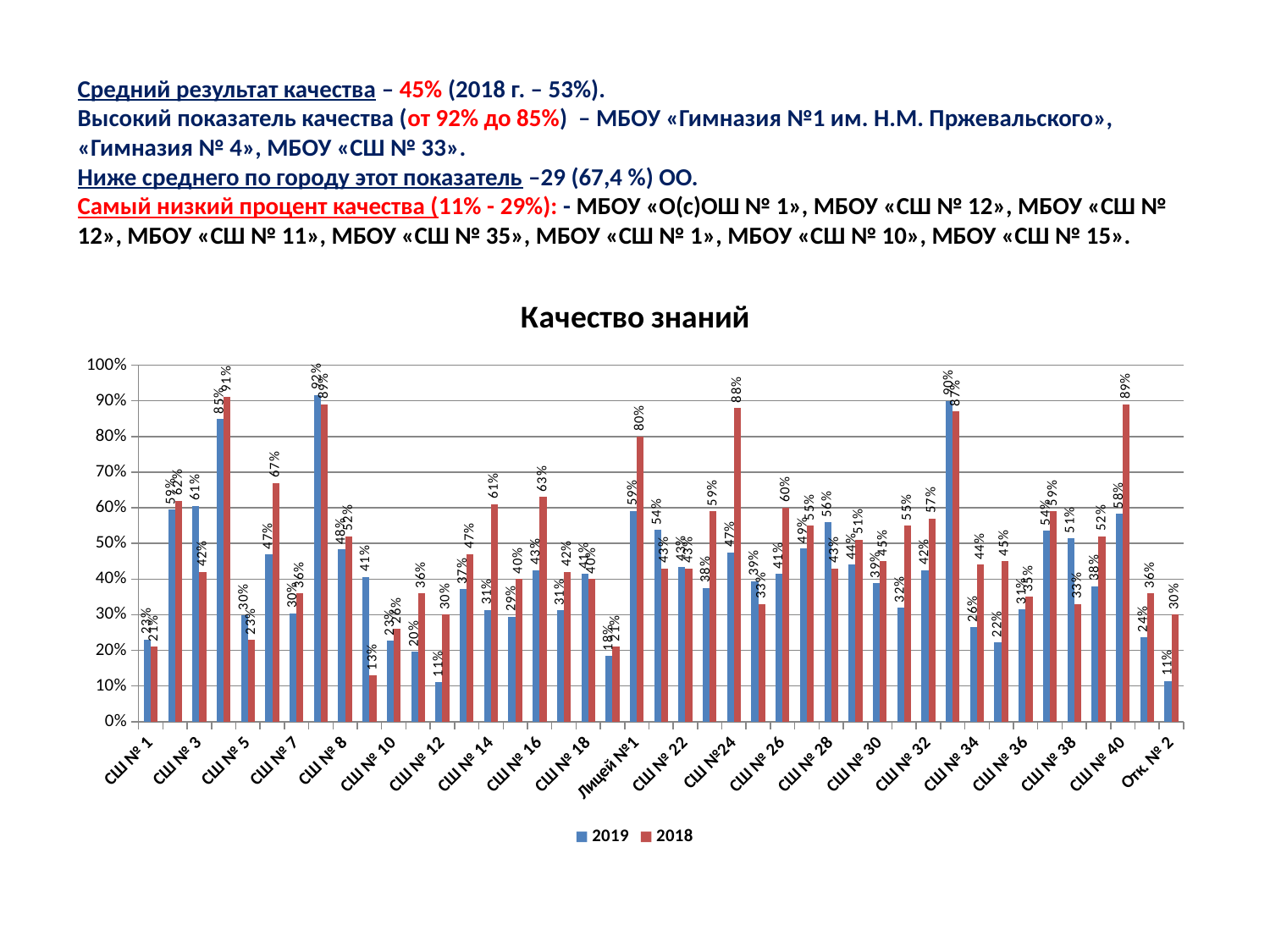
What is the title of the chart? Качество знаний For СШ № 14, which year has the larger value, 2019 or 2018? 2018 What is the difference between the 2019 and 2018 values for СШ № 3? 19 percentage points What is the 2018 value for СШ № 40? 89% What is the 2019 value for СШ № 12? 11% How many series does the legend of the chart list? 2 What is the 2018 value for Лицей №1? 80% What is the 2018 value for СШ № 1? 21% What kind of chart is shown on the slide? bar chart For СШ № 38, which year has the larger value, 2019 or 2018? 2019 What is the 2019 value for Отк. № 2? 11% What is the 2019 value for СШ № 28? 56%